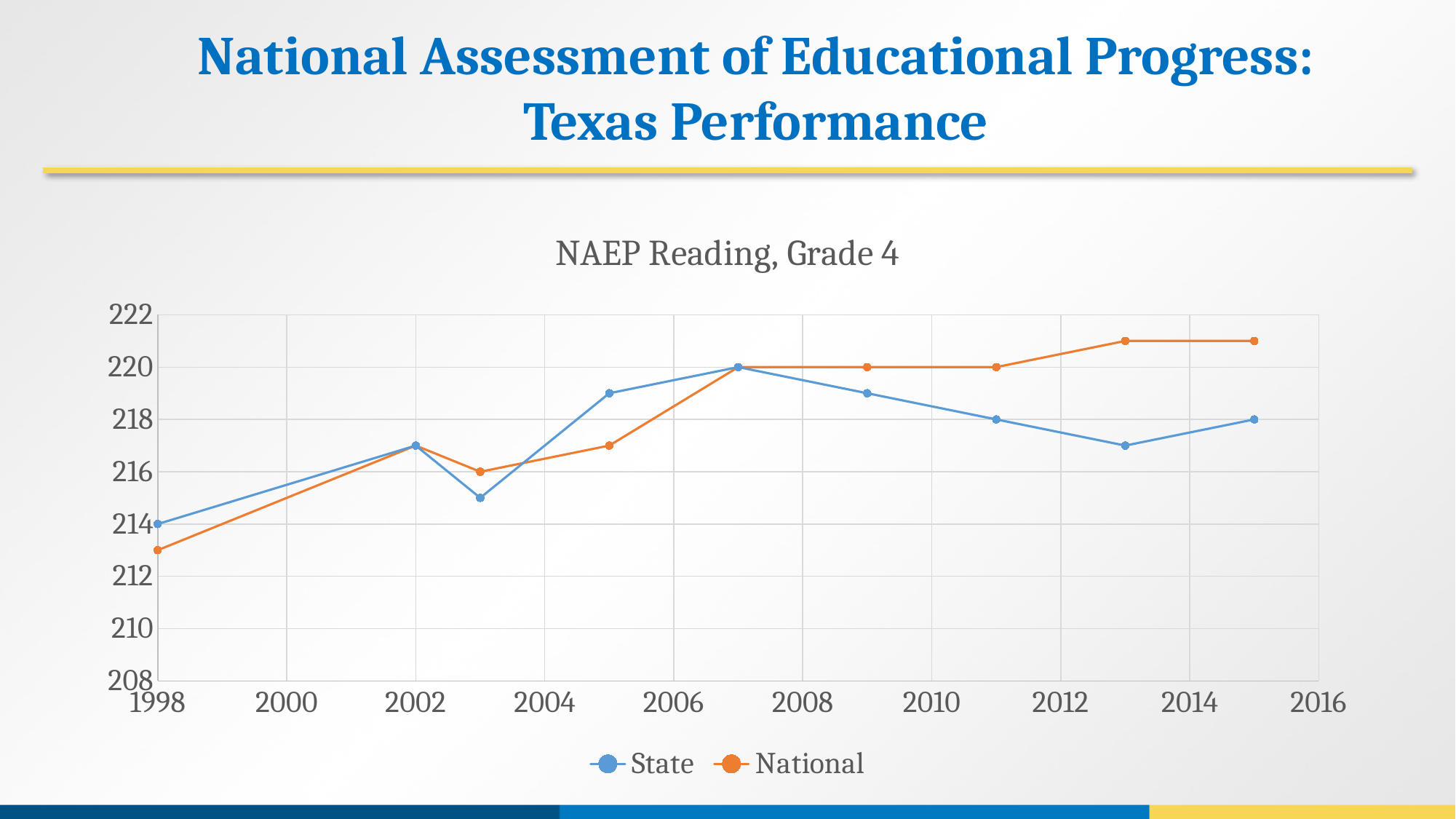
By how much did the State value increase from 1998 to 2007? 6 In which year does the State series reach its highest value? 2007 In 2015, which series has the higher value, State or National? National How many series does the legend list? 2 In which year is the National series at its lowest value? 1998 What is the State value in 2007? 220 Is the State value for 2013 greater or less than 218? less What kind of chart is shown on the slide? line chart What is the State value in 2015? 218 What is the National value in 2003? 216 Is the National value for 2015 greater or less than 220? greater What is the State value in 1998? 214